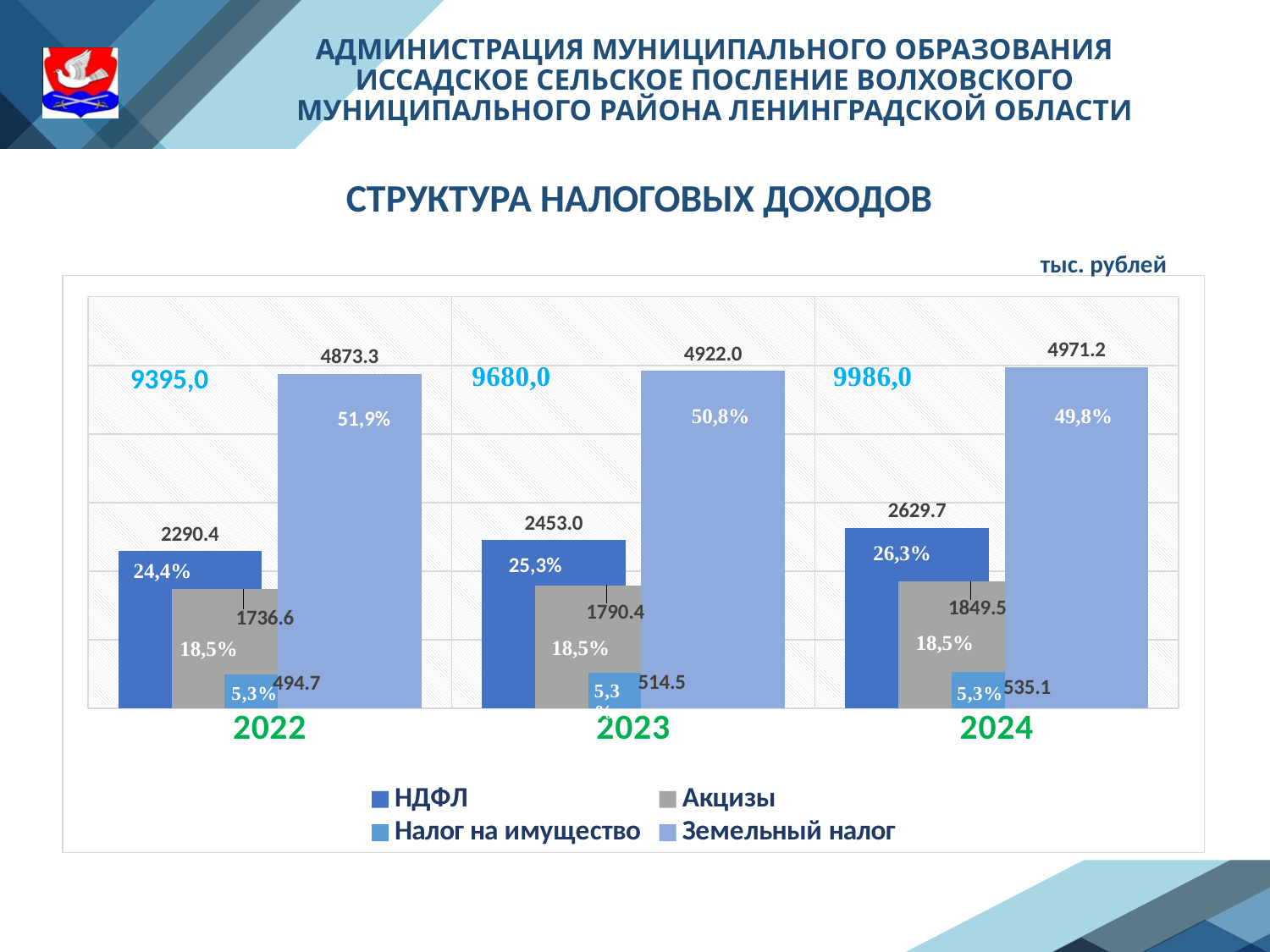
Does the value of Земельный налог rise or fall from 2022 to 2024? Rise What is the value of Акцизы for 2023? 1790.4 Which series has the highest value in 2023? Земельный налог What is the value of Налог на имущество for 2024? 535.1 What is the value of Земельный налог for 2024? 4971.2 What is the value of НДФЛ for 2022? 2290.4 Which is larger: Акцизы in 2024 or Акцизы in 2022? Акцизы in 2024 How many series does the legend list? 4 What is the difference between the НДФЛ values for 2024 and 2023? 176.7 What kind of chart is shown on the slide? Bar chart How many years are shown on the x axis? 3 Which series has the lowest value in 2022? Налог на имущество